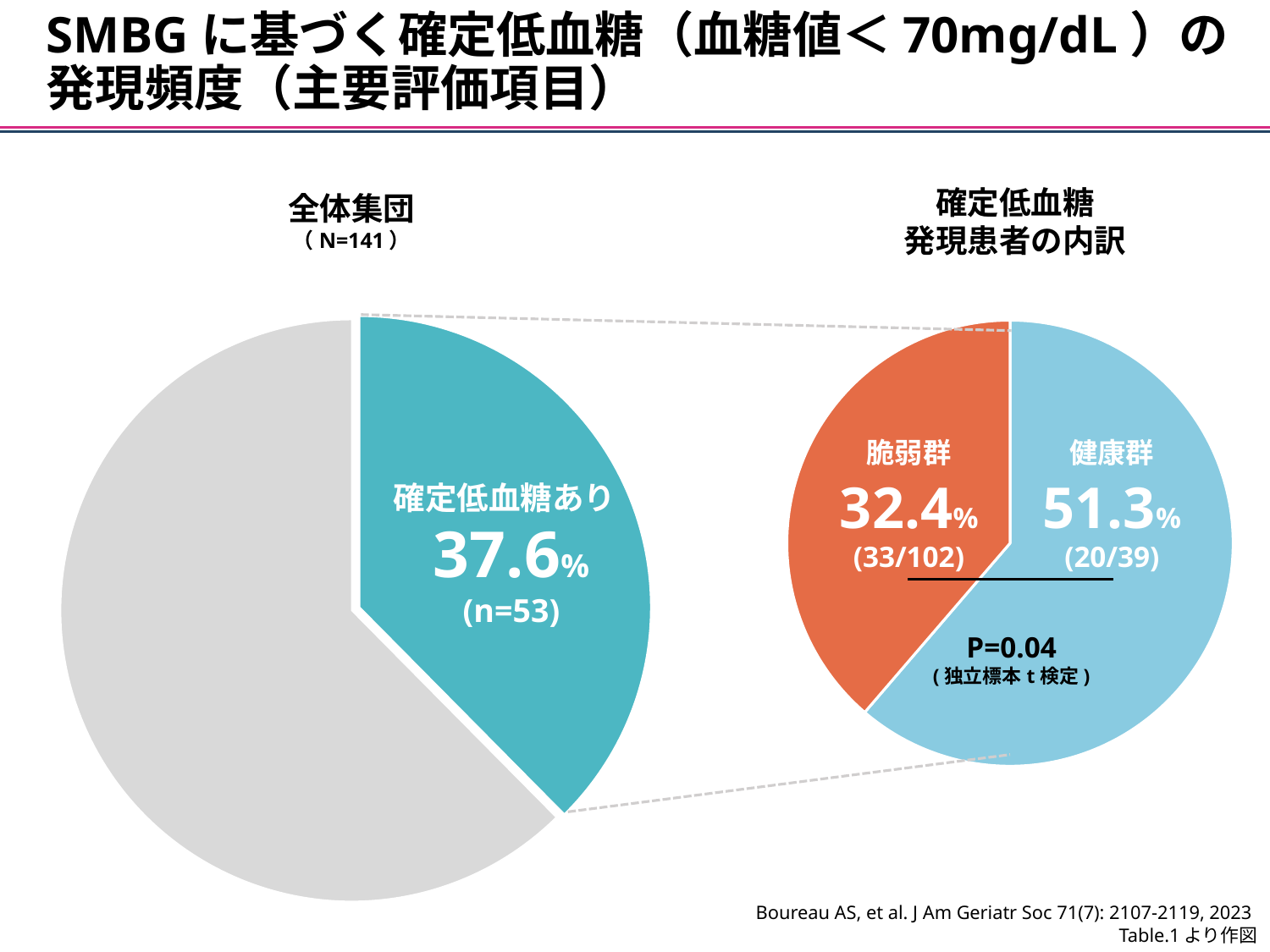
In the right chart (確定低血糖発現患者の内訳), what percentage is shown for 健康群? 51.3% In the right chart (確定低血糖発現患者の内訳), what fraction is printed under the 脆弱群 percentage? 33/102 What kind of chart is the left chart (全体集団)? Pie chart In the right chart (確定低血糖発現患者の内訳), what percentage is shown for 脆弱群? 32.4% What P value is printed on the right chart (確定低血糖発現患者の内訳)? P=0.04 In the left chart (全体集団), how many patients (n) are in the 確定低血糖あり slice? n=53 In the left chart, what is the total N of the 全体集団? N=141 In the right chart (確定低血糖発現患者の内訳), which group has the higher percentage, 脆弱群 or 健康群? 健康群 In the left chart (全体集団), what percentage is shown for 確定低血糖あり? 37.6% In the right chart (確定低血糖発現患者の内訳), what is the difference between the 健康群 percentage and the 脆弱群 percentage? 18.9 percentage points In the right chart (確定低血糖発現患者の内訳), how many groups are shown? 2 In the right chart (確定低血糖発現患者の内訳), what fraction is printed under the 健康群 percentage? 20/39